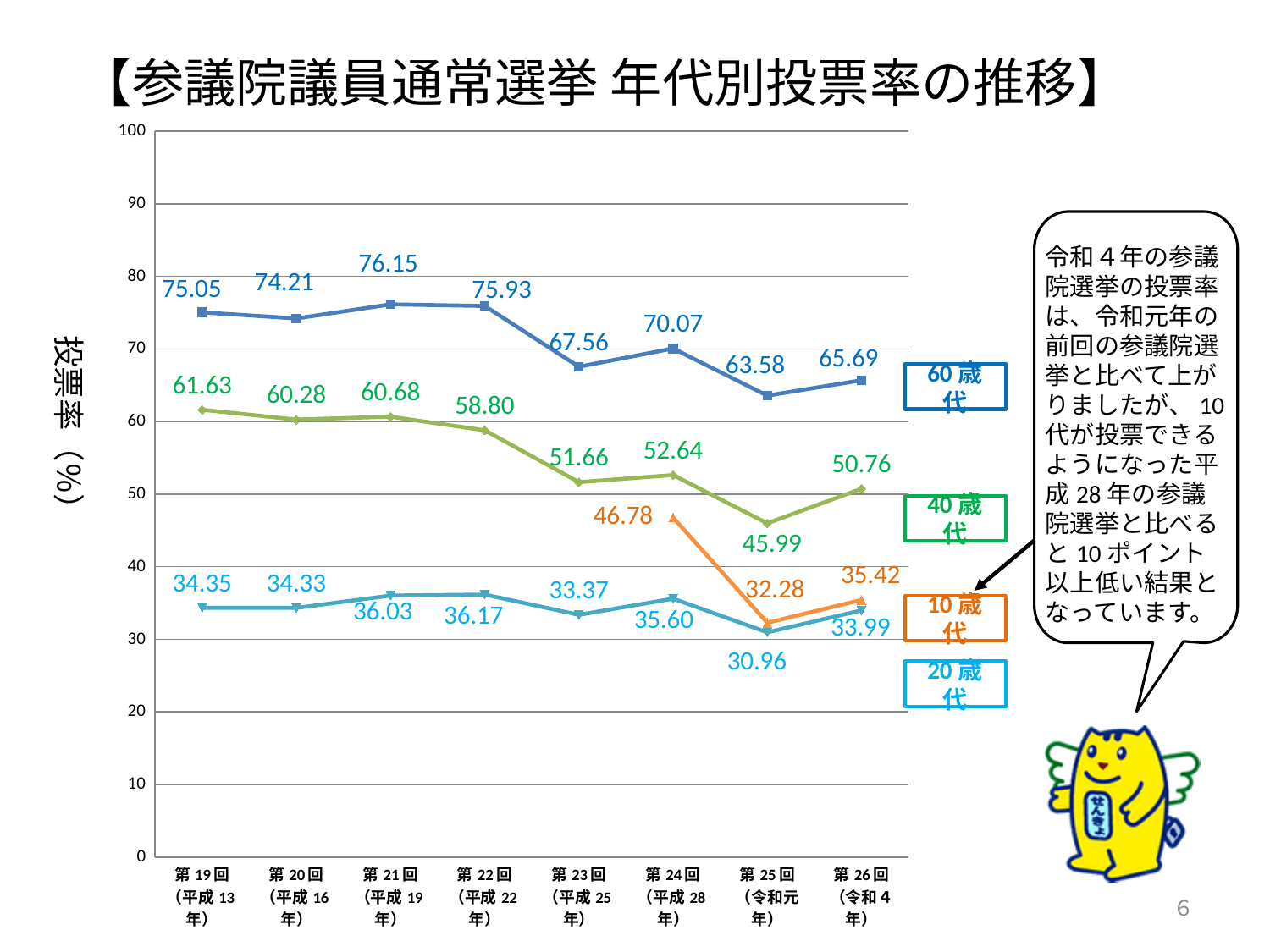
Does the 10歳代 series rise or fall from 第24回 (平成28年) to 第25回 (令和元年)? Fall What type of chart is shown on the slide? Line chart What is the difference between the 60歳代 and 40歳代 values at 第19回 (平成13年)? 13.42 Which is larger at 第26回 (令和4年): the 10歳代 value or the 20歳代 value? 10歳代 How many age-group series are plotted on the chart? 4 What is the voter turnout for the 40歳代 series at 第26回 (令和4年)? 50.76 What is the voter turnout for the 10歳代 series at 第24回 (平成28年)? 46.78 How many elections (x-axis categories) are shown on the chart? 8 What is the voter turnout for the 60歳代 series at 第21回 (平成19年)? 76.15 At which election does the 60歳代 series reach its highest value? 第21回（平成19年） What is the voter turnout for the 20歳代 series at 第25回 (令和元年)? 30.96 At which election does the 40歳代 series reach its lowest value? 第25回（令和元年）